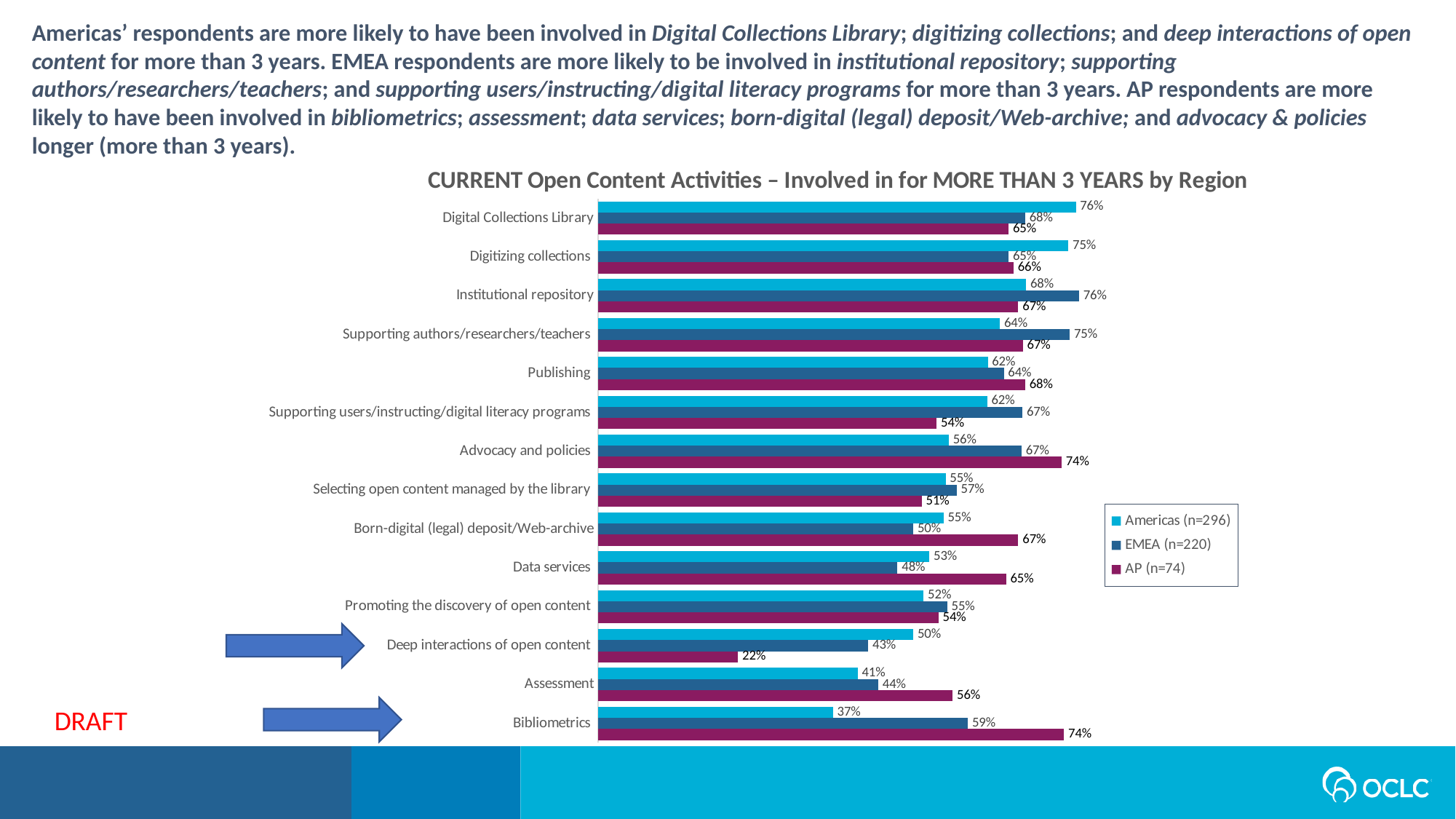
What is the sample size for EMEA shown in the legend? n=220 What kind of chart is shown? Bar chart Which is larger for Institutional repository, the Americas value or the EMEA value? EMEA How many categories are shown on the chart? 14 How many series does the legend list? 3 Which is larger for Assessment, the EMEA value or the AP value? AP What is the AP value for Deep interactions of open content? 22% Which category has the lowest AP value? Deep interactions of open content What is the EMEA value for Bibliometrics? 59% Which category has the lowest Americas value? Bibliometrics What is the difference between the AP and Americas values for Bibliometrics? 37% What is the Americas value for Digital Collections Library? 76%